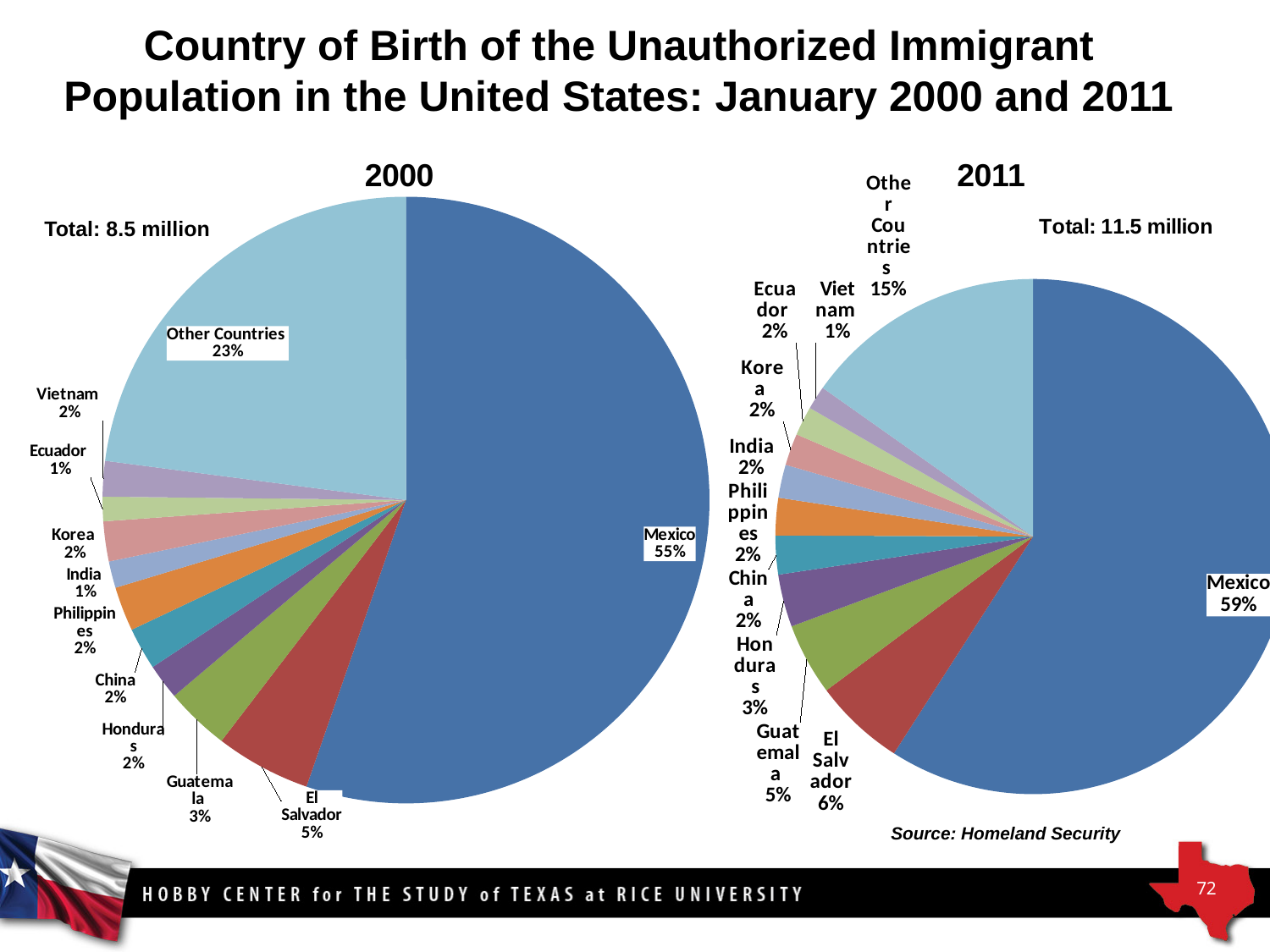
In the 2000 pie chart, which country has the smallest slice, Ecuador or El Salvador? Ecuador In the 2011 pie chart, what share of the unauthorized immigrant population was born in Mexico? 59% How many slices does the 2011 pie chart have? 11 What type of chart is used to show the 2000 data? Pie chart In the 2011 pie chart, which country has the largest slice? Mexico In the 2011 pie chart, what percentage is shown for Other Countries? 15% In the 2000 pie chart, what percentage is shown for Guatemala? 3% In the 2011 pie chart, what percentage is shown for El Salvador? 6% In the 2000 pie chart, what share of the unauthorized immigrant population was born in Mexico? 55% By how many percentage points did Mexico's share increase from the 2000 pie chart to the 2011 pie chart? 4 percentage points In the 2000 pie chart, what percentage is shown for Other Countries? 23% What total population is stated for the 2011 pie chart? 11.5 million